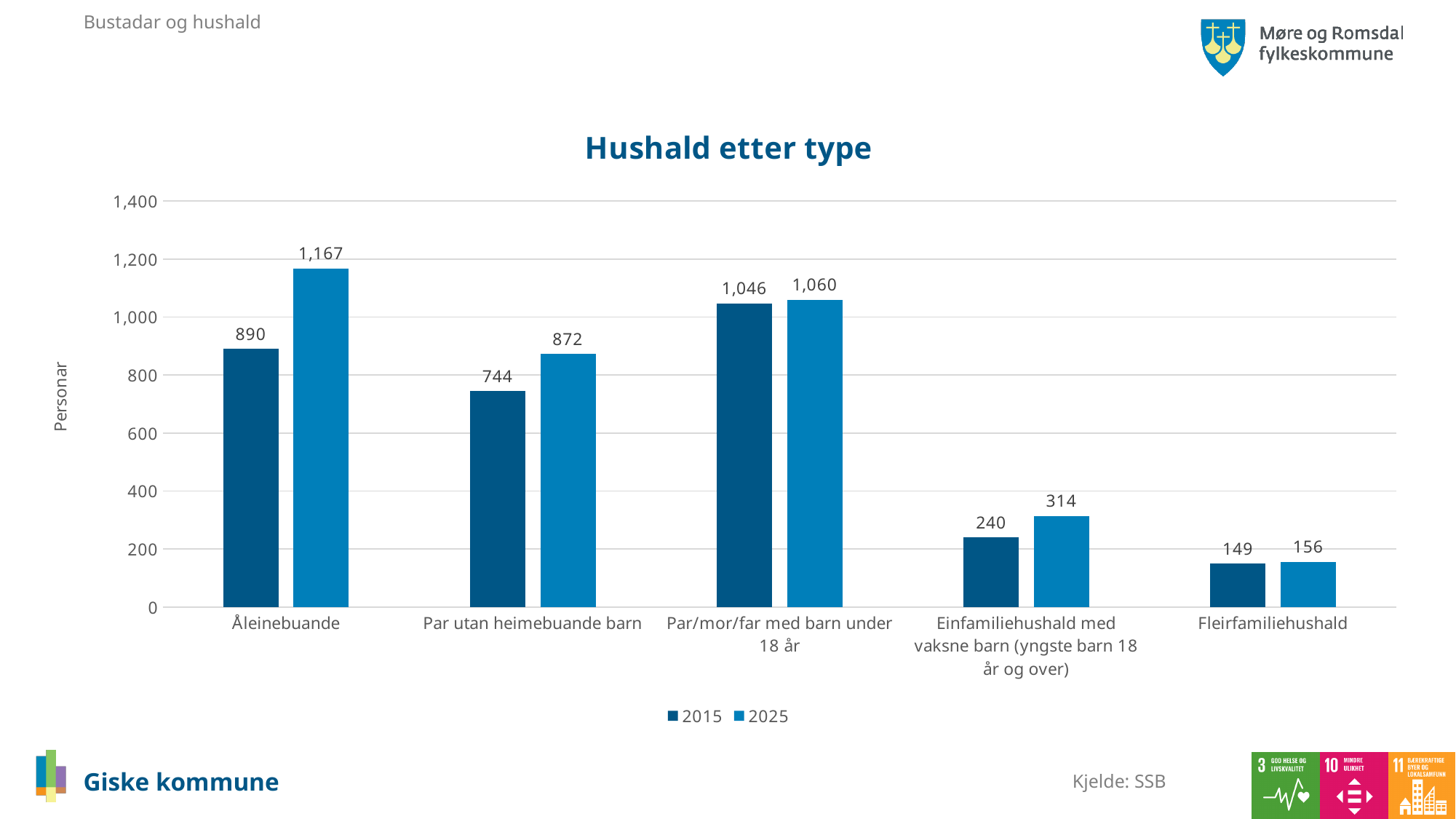
Which category has the highest value in 2025? Åleinebuande How many categories are shown on the x axis? 5 What is the value for Par utan heimebuande barn in 2015? 744 What is the value for Fleirfamiliehushald in 2025? 156 What is the difference between the 2025 and 2015 values for Åleinebuande? 277 What is the title of the chart? Hushald etter type Which category has the lowest value in 2015? Fleirfamiliehushald What is the difference between the 2025 and 2015 values for Einfamiliehushald med vaksne barn (yngste barn 18 år og over)? 74 What kind of chart is shown on the slide? Bar chart Which is larger: the 2015 value for Åleinebuande or the 2015 value for Par/mor/far med barn under 18 år? Par/mor/far med barn under 18 år How many series does the legend list? 2 What is the value for Åleinebuande in 2025? 1,167